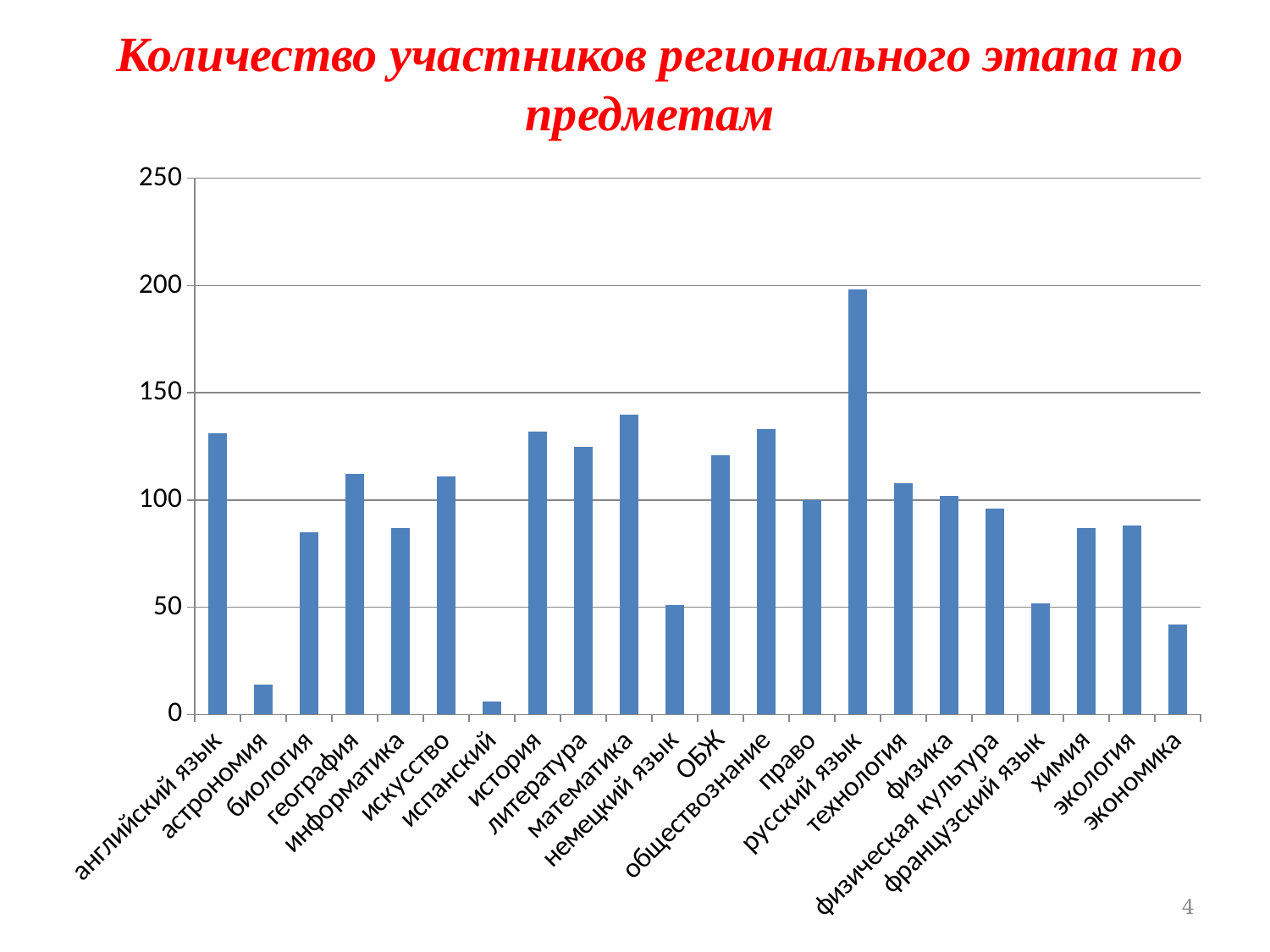
Which subject has the highest number of participants? русский язык What is the title of the chart? Количество участников регионального этапа по предметам Which has more participants, математика or литература? математика Which subject has the lowest number of participants? испанский Which has more participants, русский язык or обществознание? русский язык How many subjects (categories) are shown on the x axis? 22 Is the value for астрономия greater or less than 50? less Is the value for математика greater or less than 150? less Is the value for английский язык greater or less than 100? greater What kind of chart is shown on the slide? bar chart